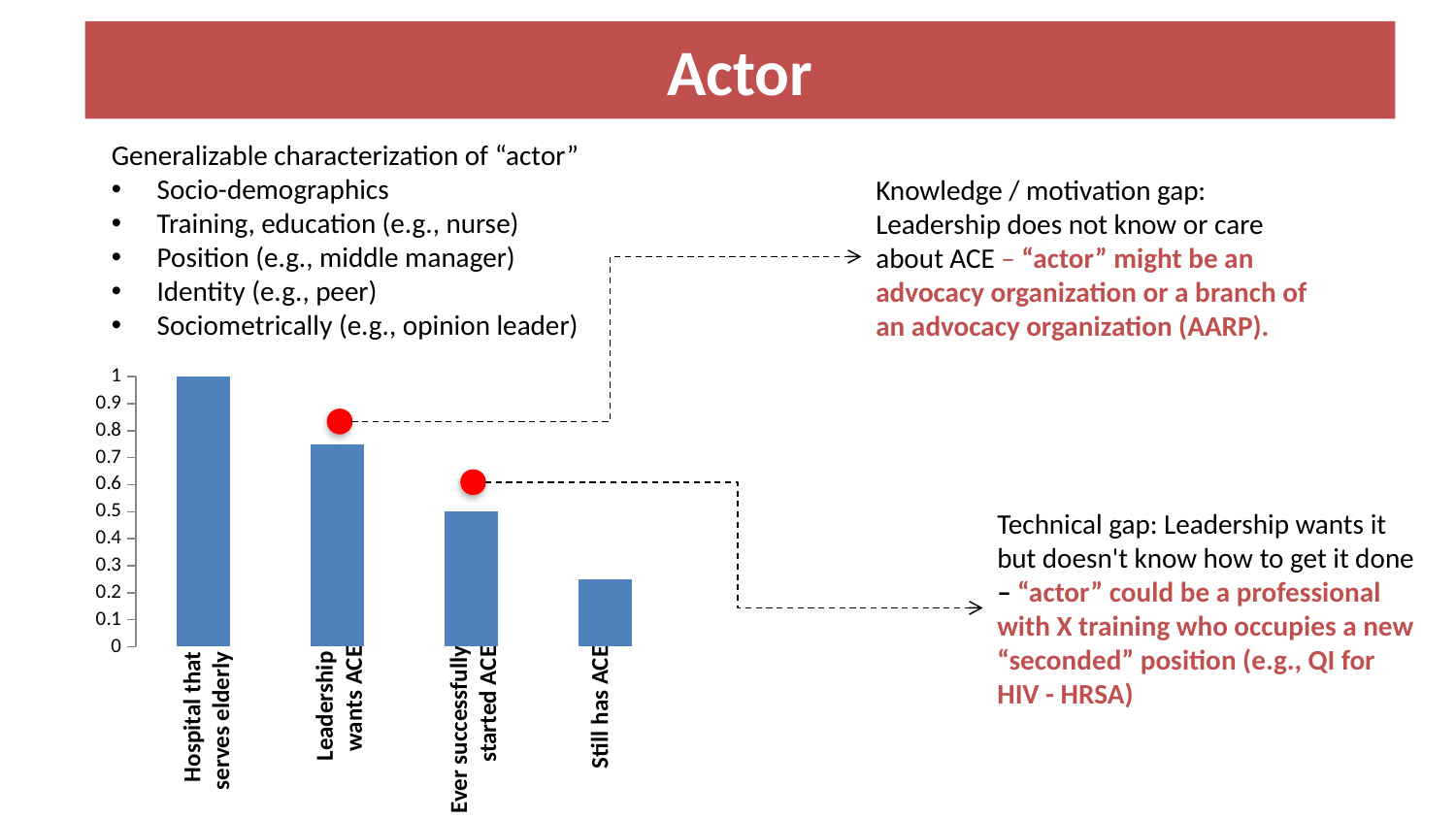
What kind of chart is shown on the slide? bar chart What is the value for "Hospital that serves elderly"? 1 Do the bar values rise or fall from left to right along the x axis? fall Is the value for "Still has ACE" greater or less than 0.3? less Which is larger, the value for "Leadership wants ACE" or the value for "Still has ACE"? Leadership wants ACE What is the difference between the values for "Hospital that serves elderly" and "Ever successfully started ACE"? 0.5 Which category has the highest bar in the chart? Hospital that serves elderly Which category has the lowest bar in the chart? Still has ACE How many categories are plotted in the bar chart? 4 What is the value for "Ever successfully started ACE"? 0.5 What is the highest tick value shown on the vertical axis of the chart? 1 Is the value for "Leadership wants ACE" greater or less than 0.7? greater